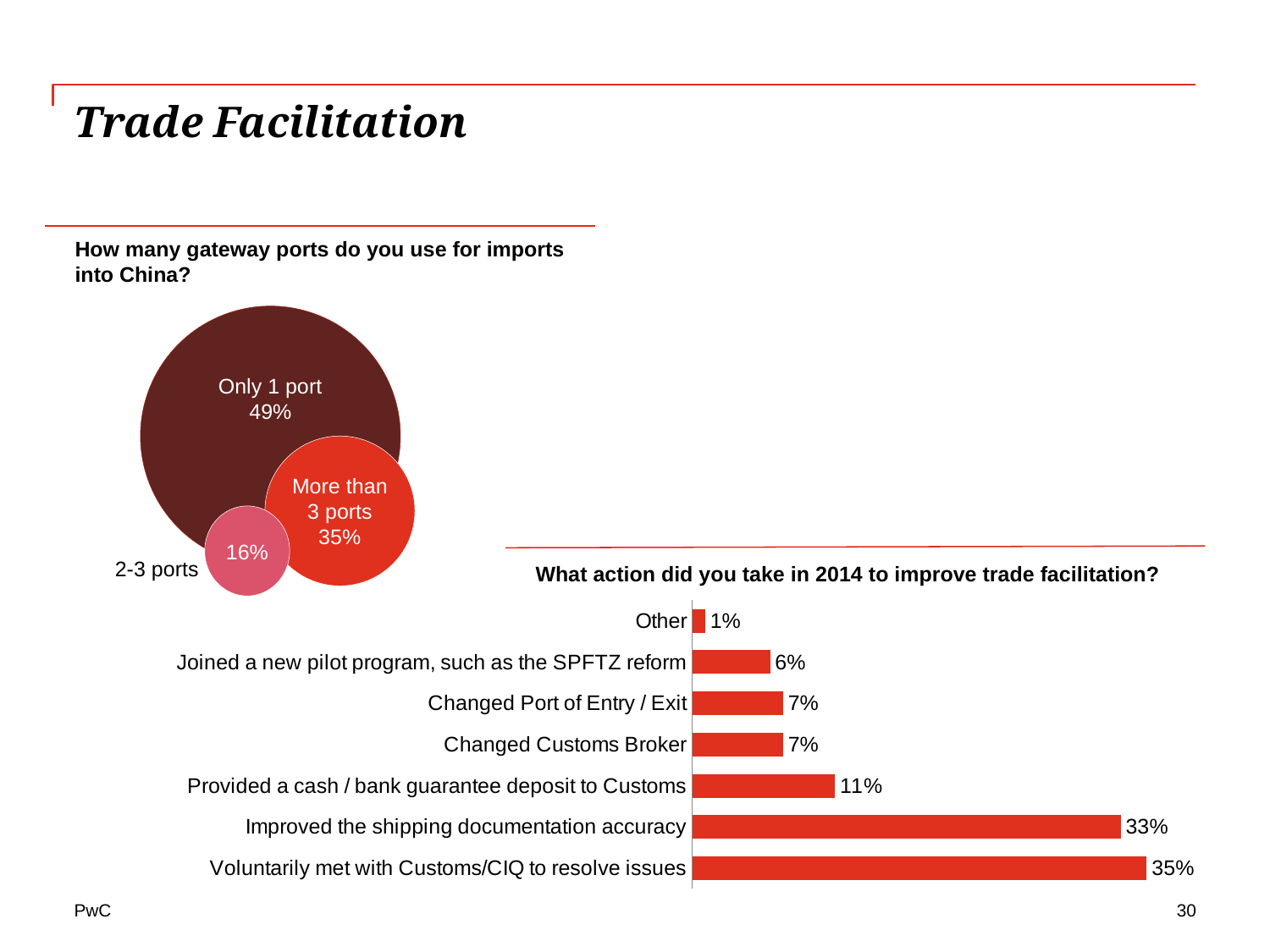
In the chart 'What action did you take in 2014 to improve trade facilitation?', which action has the lowest value? Other In the chart 'How many gateway ports do you use for imports into China?', what percentage of respondents use only 1 port? 49% In the chart 'How many gateway ports do you use for imports into China?', what is the difference between 'Only 1 port' and 'More than 3 ports'? 14% In the chart 'What action did you take in 2014 to improve trade facilitation?', what is the difference between 'Voluntarily met with Customs/CIQ to resolve issues' and 'Improved the shipping documentation accuracy'? 2% In the chart 'What action did you take in 2014 to improve trade facilitation?', which is larger: 'Joined a new pilot program, such as the SPFTZ reform' or 'Changed Port of Entry / Exit'? Changed Port of Entry / Exit What kind of chart is 'What action did you take in 2014 to improve trade facilitation?'? Bar chart In the chart 'What action did you take in 2014 to improve trade facilitation?', which action has the highest value? Voluntarily met with Customs/CIQ to resolve issues In the chart 'What action did you take in 2014 to improve trade facilitation?', what percentage of respondents voluntarily met with Customs/CIQ to resolve issues? 35% In the chart 'How many gateway ports do you use for imports into China?', what percentage of respondents use 2-3 ports? 16% In the chart 'What action did you take in 2014 to improve trade facilitation?', what is the value for 'Improved the shipping documentation accuracy'? 33% How many actions are listed in the chart 'What action did you take in 2014 to improve trade facilitation?'? 7 In the chart 'What action did you take in 2014 to improve trade facilitation?', what is the value for 'Provided a cash / bank guarantee deposit to Customs'? 11%